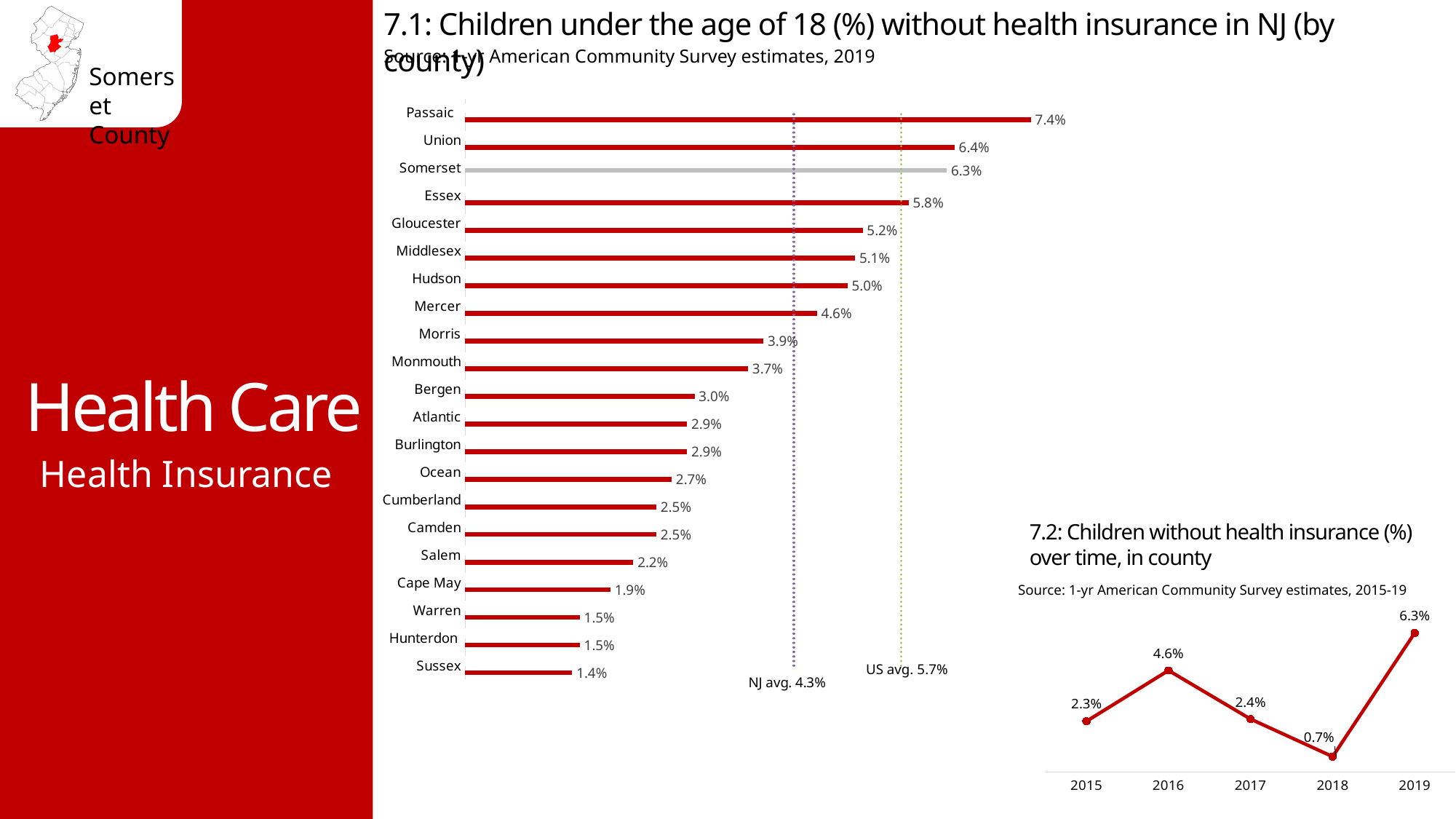
In chart 7.1, what is the difference between Passaic and Union? 1.0% In chart 7.1, which county has the highest value? Passaic What kind of chart is chart 7.2? line chart In chart 7.1, which county has the lowest value? Sussex In chart 7.1, what is the value for Somerset? 6.3% In chart 7.2, which year has the highest value? 2019 In chart 7.1, how many counties are shown? 21 In chart 7.1, what is the NJ average shown? 4.3% In chart 7.2, what is the difference between the 2019 and 2015 values? 4.0% In chart 7.1, which is larger, the value for Essex or the value for Mercer? Essex In chart 7.2, what is the value for 2018? 0.7% What kind of chart is chart 7.1? bar chart